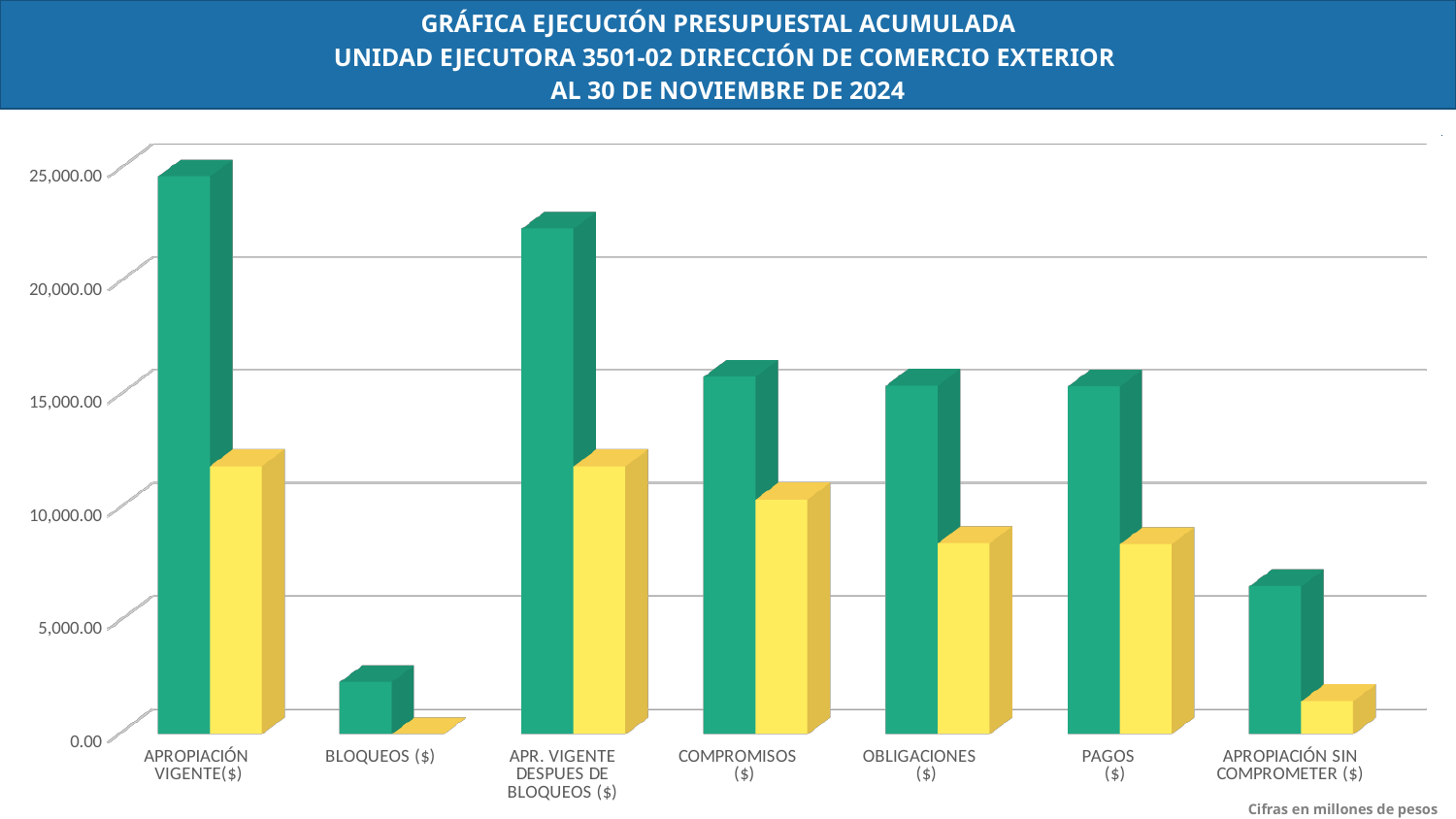
Which category has the shortest green bar? BLOQUEOS ($) Is the green bar for APROPIACIÓN SIN COMPROMETER ($) greater or less than 5,000.00? greater What kind of chart is shown on the slide? bar chart Is the green bar for APROPIACIÓN VIGENTE($) greater or less than 20,000.00? greater According to the note at the bottom right of the chart, in what units are the figures expressed? Cifras en millones de pesos Which is larger, the yellow bar for COMPROMISOS ($) or the yellow bar for OBLIGACIONES ($)? COMPROMISOS ($) Which category has the tallest green bar? APROPIACIÓN VIGENTE($) Is the green bar for BLOQUEOS ($) greater or less than 5,000.00? less How many categories are shown along the x axis of the chart? 7 Which is larger, the green bar for APROPIACIÓN VIGENTE($) or the green bar for APR. VIGENTE DESPUES DE BLOQUEOS ($)? APROPIACIÓN VIGENTE($)